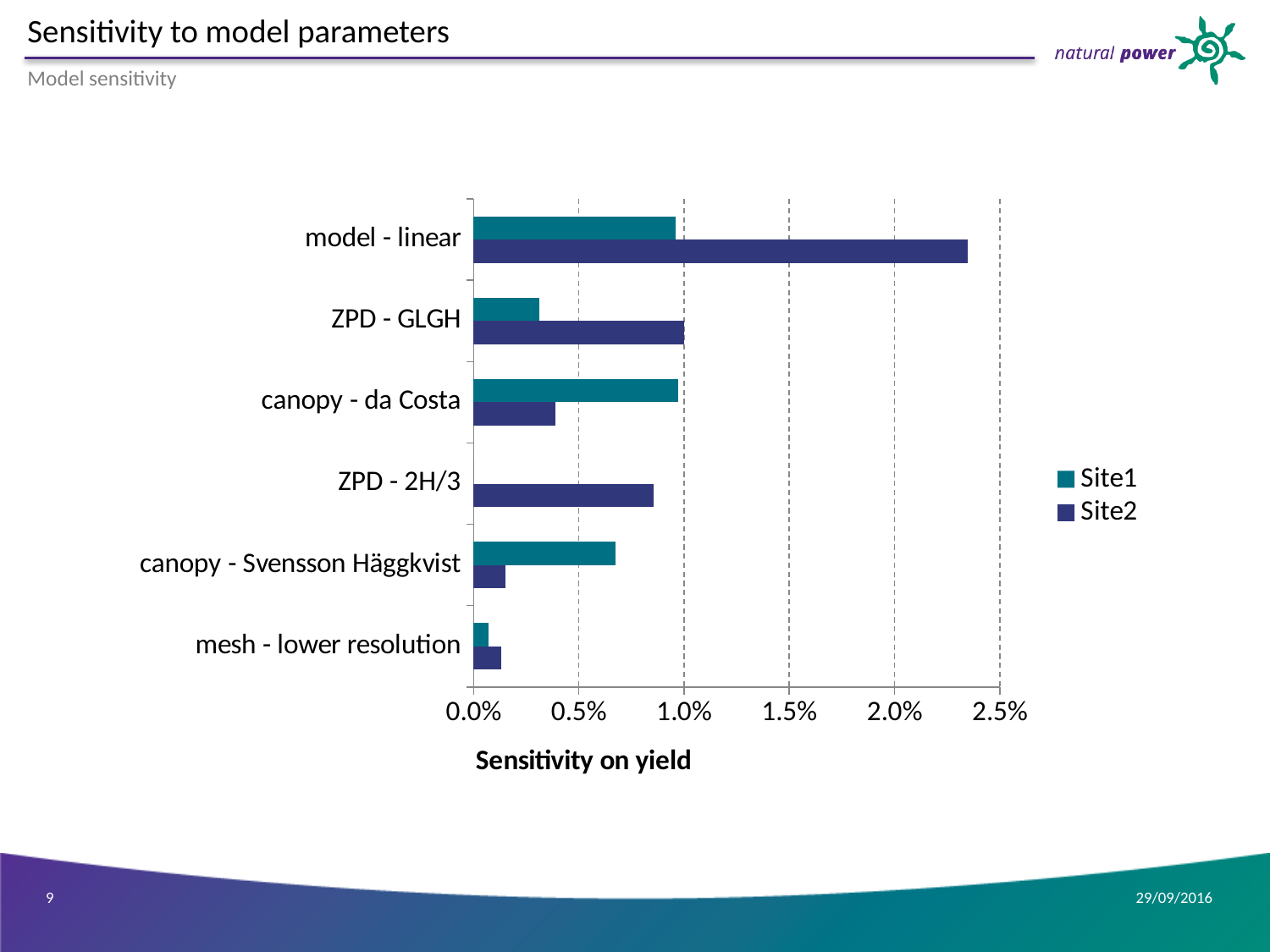
Is the Site1 value for canopy - Svensson Häggkvist greater or less than 0.5%? greater What kind of chart is shown on the slide? bar chart How many series does the legend list? 2 Which category has the highest Site2 sensitivity on yield? model - linear For canopy - da Costa, which site has the larger sensitivity on yield? Site1 Is the Site2 value for model - linear greater or less than 2.0%? greater Is the Site2 value for ZPD - 2H/3 greater or less than 0.5%? greater How many model parameter categories are plotted on the chart? 6 For model - linear, which site has the larger sensitivity on yield? Site2 Which category has the lowest Site2 sensitivity on yield? mesh - lower resolution What is the title of the horizontal axis? Sensitivity on yield